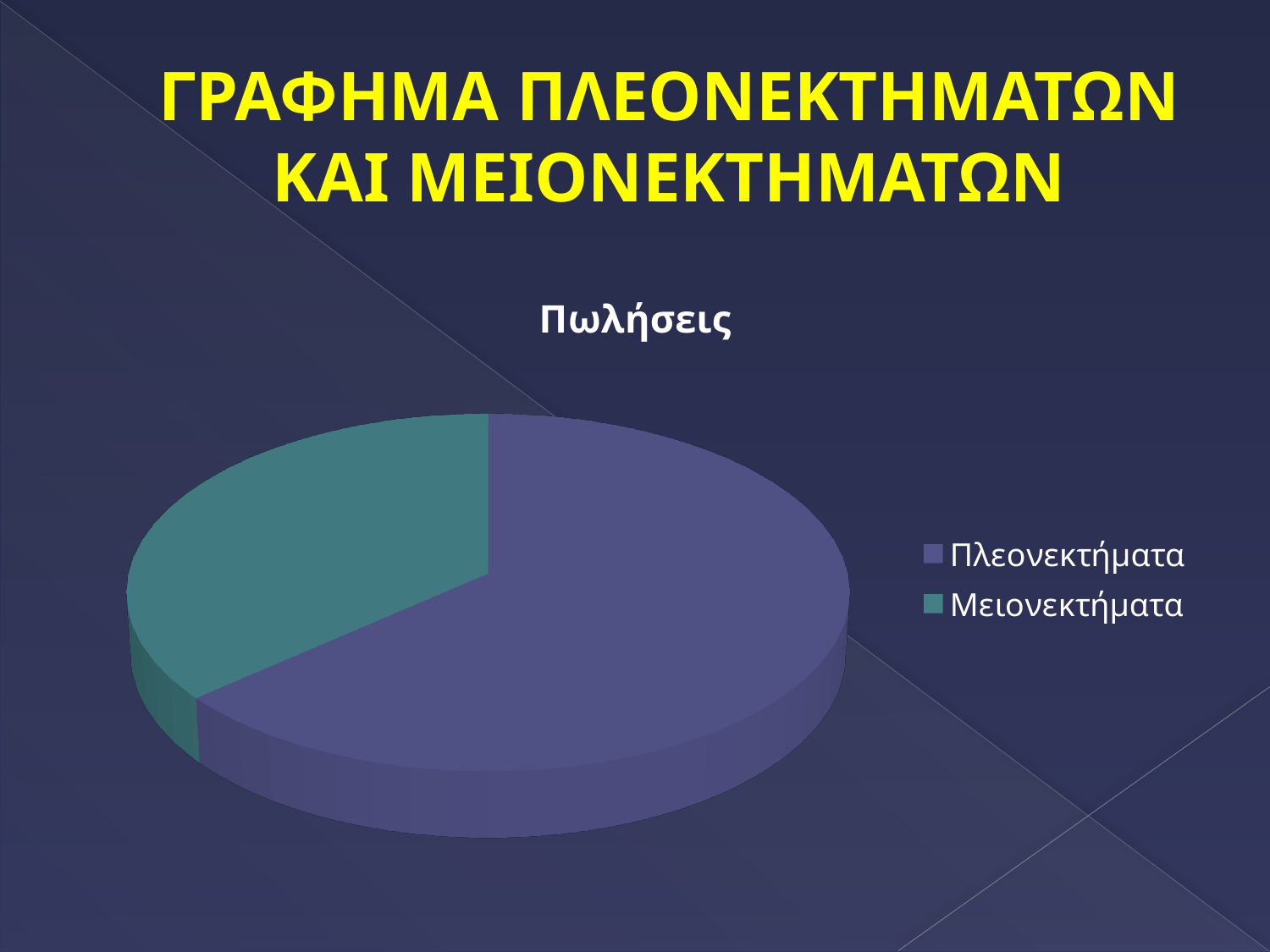
Which category has the smallest slice of the pie? Μειονεκτήματα Which slice is larger, Πλεονεκτήματα or Μειονεκτήματα? Πλεονεκτήματα How many slices does the pie chart have? 2 Which category has the largest slice of the pie? Πλεονεκτήματα What kind of chart is shown on the slide? Pie chart Which category is shown in the teal/green colour? Μειονεκτήματα What is the title of the chart? Πωλήσεις How many entries does the legend list? 2 Does the Πλεονεκτήματα slice take up more or less than half of the pie? more Does the Μειονεκτήματα slice take up more or less than half of the pie? less